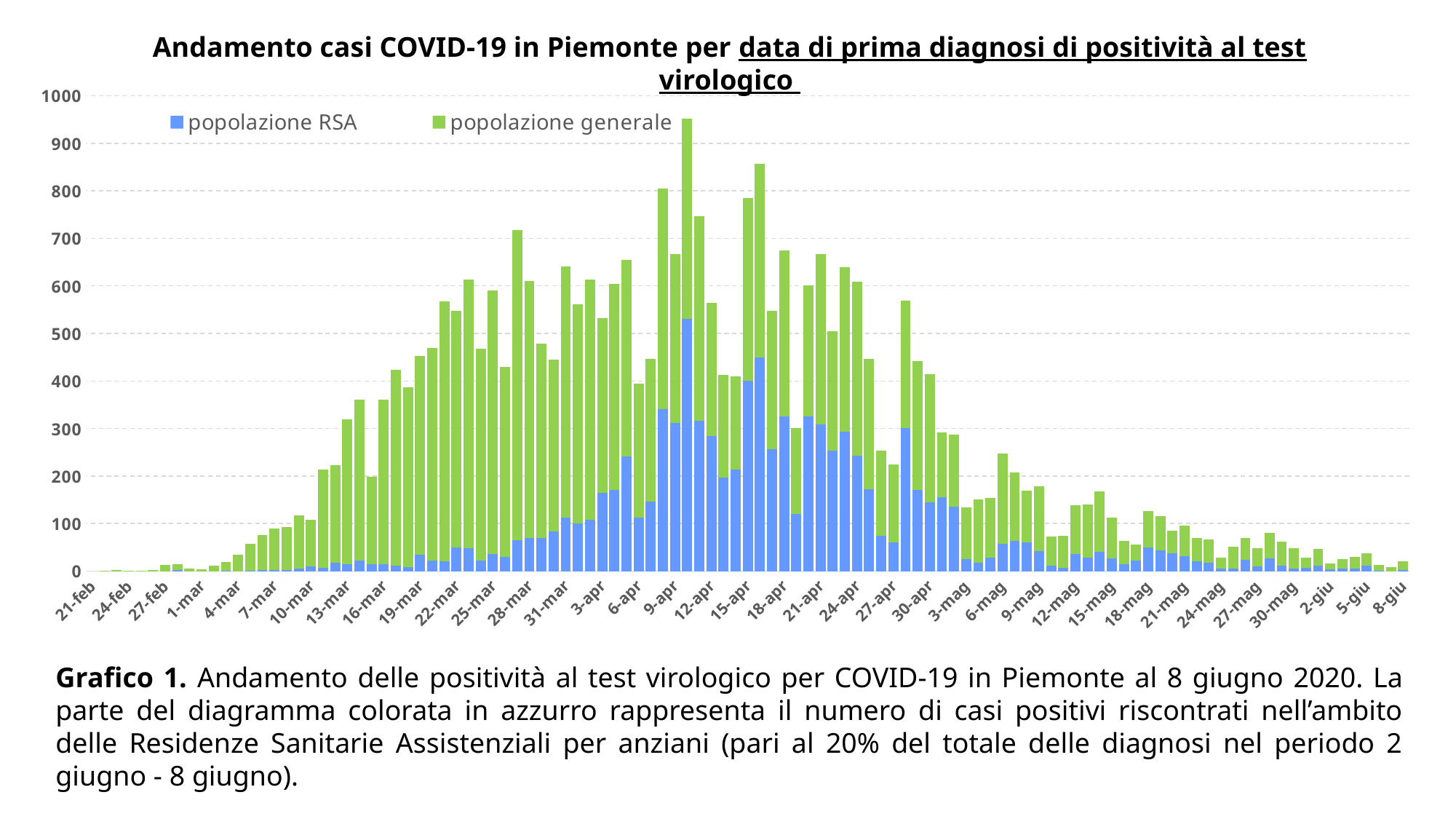
Is the highest total bar in the chart greater or less than 900? greater Which series is shown in blue? popolazione RSA Is the total value for 9-apr greater or less than 500? greater What kind of chart is shown on the slide? Stacked bar chart Is the total value for 21-feb greater or less than 100? less Which series is shown in green? popolazione generale How many series does the legend list? 2 Do the total values generally rise or fall from 9-apr to 8-giu? fall Do the total values generally rise or fall from 21-feb to 9-apr? rise